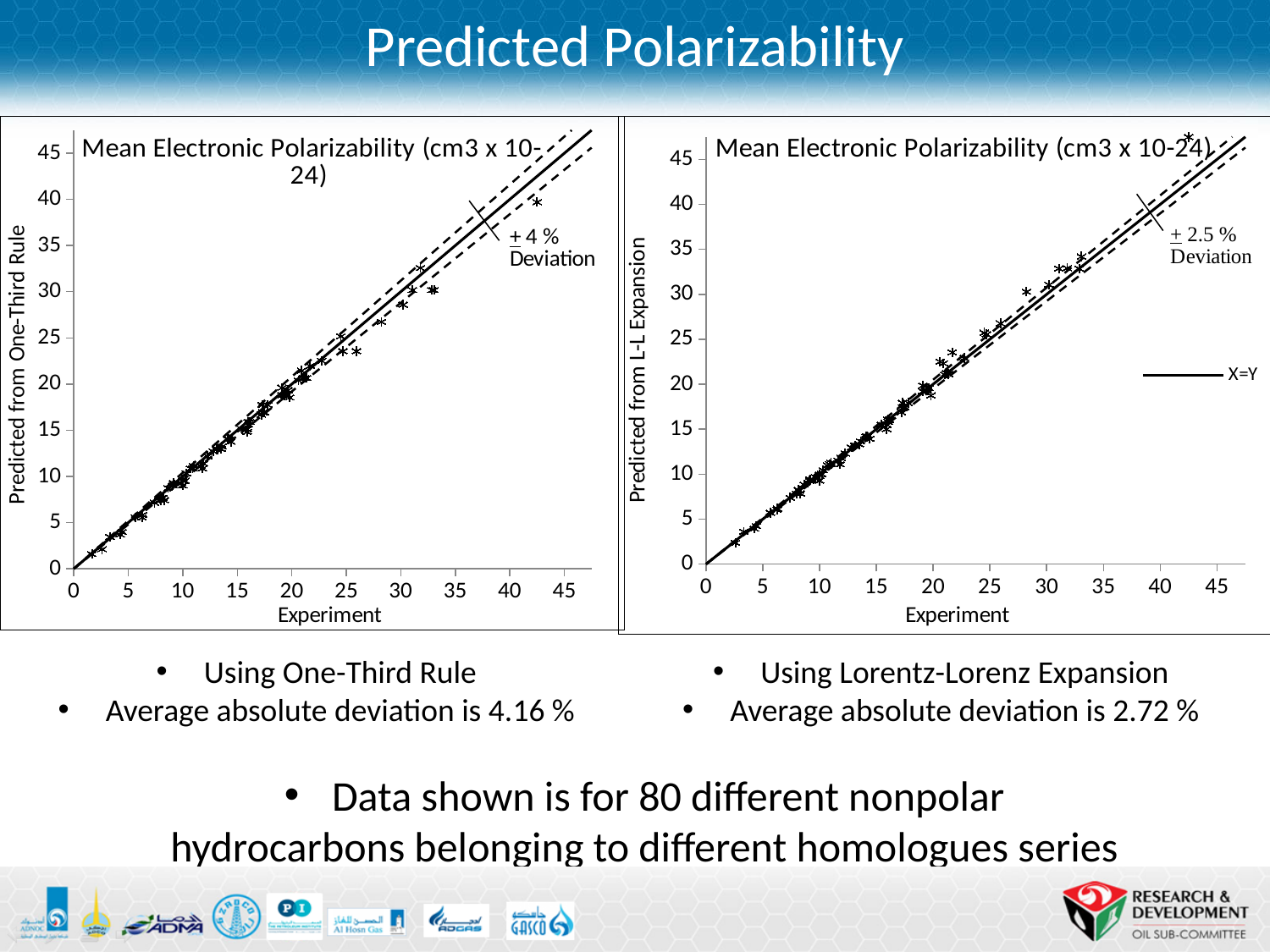
In the right chart (Predicted from L-L Expansion), do the plotted values rise or fall as the Experiment value increases along the x axis? Rise In the left chart (Predicted from One-Third Rule), what is the label of the x axis? Experiment How many series does the legend of the right chart (Predicted from L-L Expansion) list? 1 What kind of chart is the left chart, titled 'Mean Electronic Polarizability (cm3 x 10-24)' with y-axis 'Predicted from One-Third Rule'? Scatter chart What deviation band is annotated on the left chart (Predicted from One-Third Rule)? ± 4 % Deviation What deviation band is annotated on the right chart (Predicted from L-L Expansion)? ± 2.5 % Deviation What kind of chart is the right chart, with y-axis 'Predicted from L-L Expansion'? Scatter chart In the left chart (Predicted from One-Third Rule), do the plotted values rise or fall as the Experiment value increases along the x axis? Rise